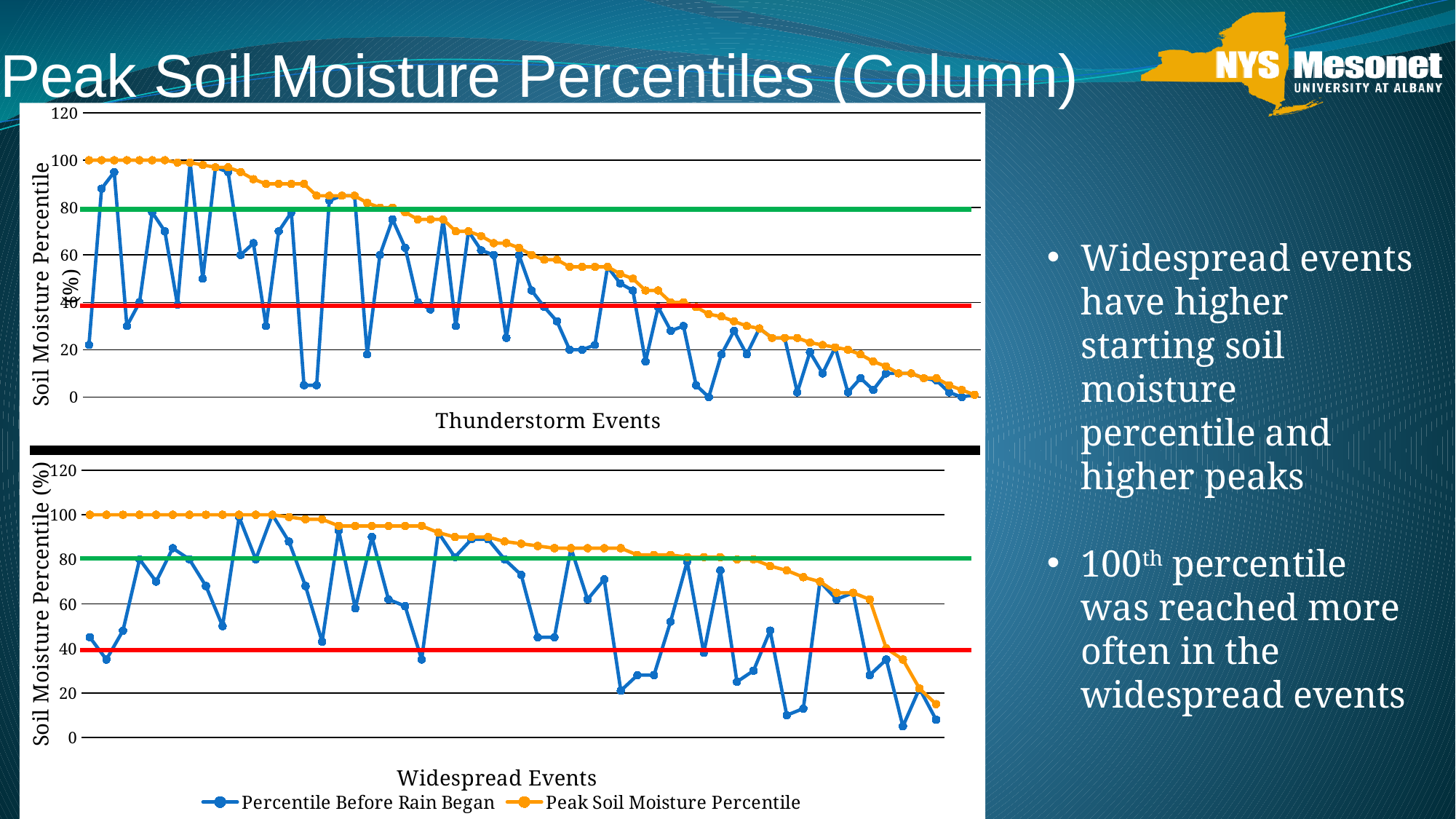
In the Thunderstorm Events chart, what is the Peak Soil Moisture Percentile value for the first (leftmost) event? 100 What is the y-axis label on the Widespread Events chart? Soil Moisture Percentile (%) How many series does the legend at the bottom of the slide list? 2 In the Thunderstorm Events chart, does the Peak Soil Moisture Percentile series rise or fall from left to right? Fall In the Widespread Events chart, what is the Peak Soil Moisture Percentile value for the first (leftmost) event? 100 What type of chart is the top chart labelled Thunderstorm Events? Line chart In the Thunderstorm Events chart, is the Percentile Before Rain Began for the first (leftmost) event greater or less than 40? less In the Widespread Events chart, does the Peak Soil Moisture Percentile series rise or fall along the x axis? Fall In the Widespread Events chart, is the Peak Soil Moisture Percentile for the last (rightmost) event greater or less than 40? less Which colour is used for the Peak Soil Moisture Percentile series in the legend? Orange In the Widespread Events chart, is the Percentile Before Rain Began for the first (leftmost) event greater or less than 40? greater